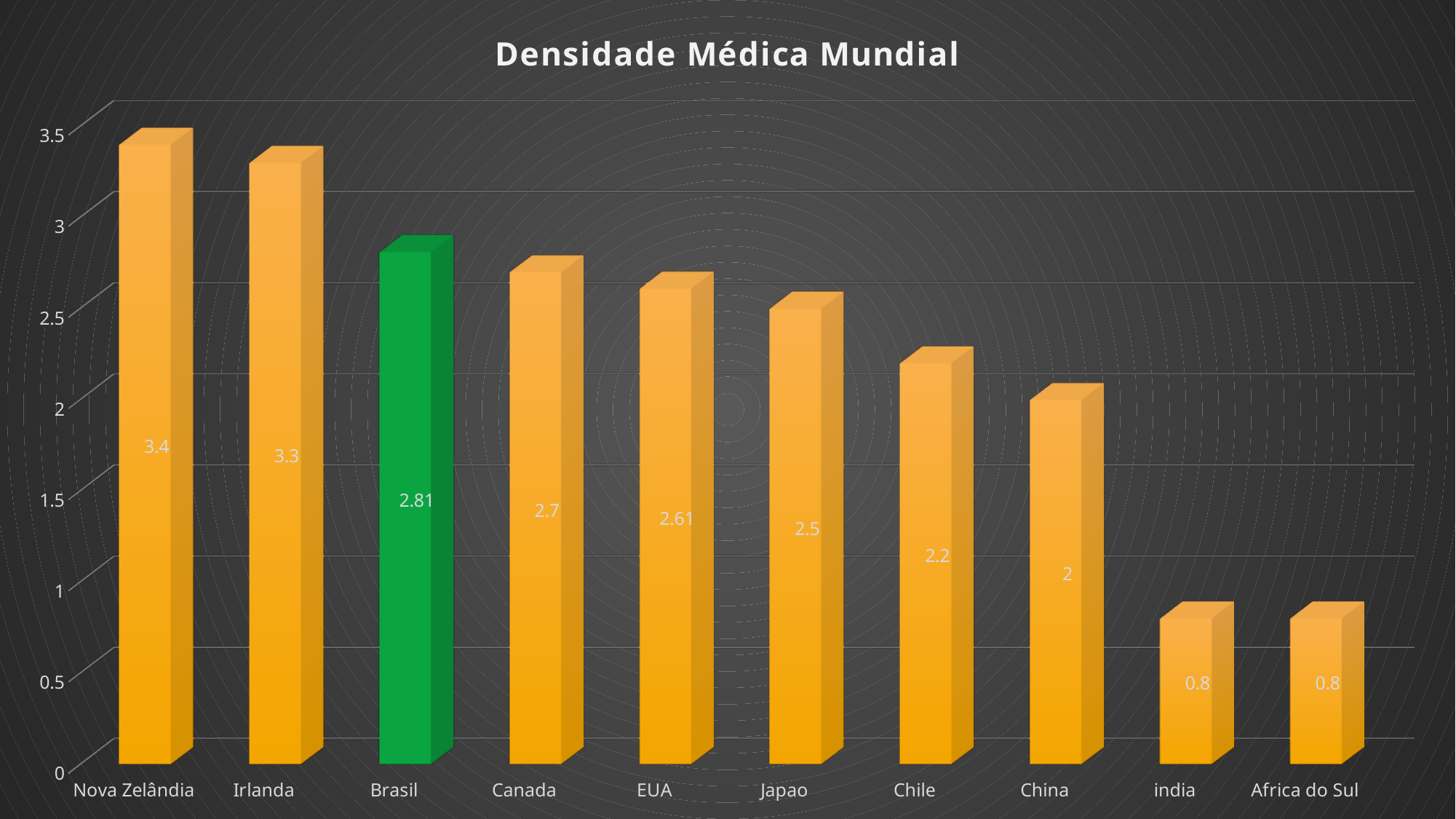
What is the title of the chart? Densidade Médica Mundial How many categories are shown on the x axis? 10 What is the difference between the values for Brasil and China? 0.81 Which category has the highest value? Nova Zelândia What is the difference between the values for Nova Zelândia and Irlanda? 0.1 Which is larger, the value for Canada or the value for Japao? Canada What is the value for Brasil? 2.81 Do the values rise or fall from left to right along the x axis? fall What kind of chart is shown on the slide? bar chart What is the value for Chile? 2.2 Is the value for China greater or less than 2.5? less What is the value for EUA? 2.61